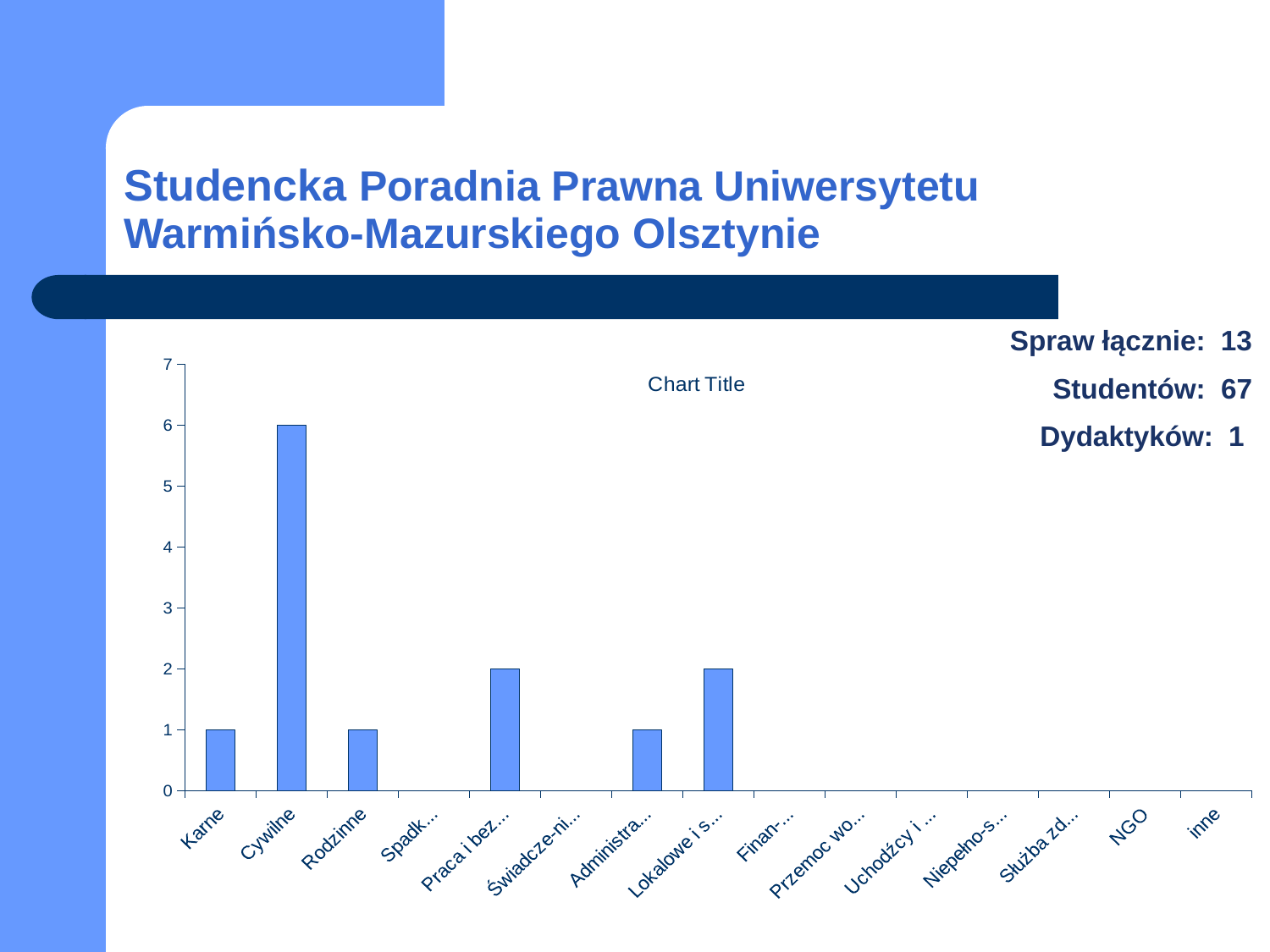
What is the value for NGO? 0 How many categories are shown on the x axis? 15 What is the value for Rodzinne? 1 Is the value for Cywilne greater or less than 5? greater Which is larger, the value for Cywilne or the value for Rodzinne? Cywilne What is the highest value shown on the vertical axis? 7 What kind of chart is shown on the slide? bar chart What is the difference between the values for Cywilne and Karne? 5 What is the value for Cywilne? 6 What is the value for Karne? 1 What is the title shown on the chart? Chart Title Which category has the highest value? Cywilne